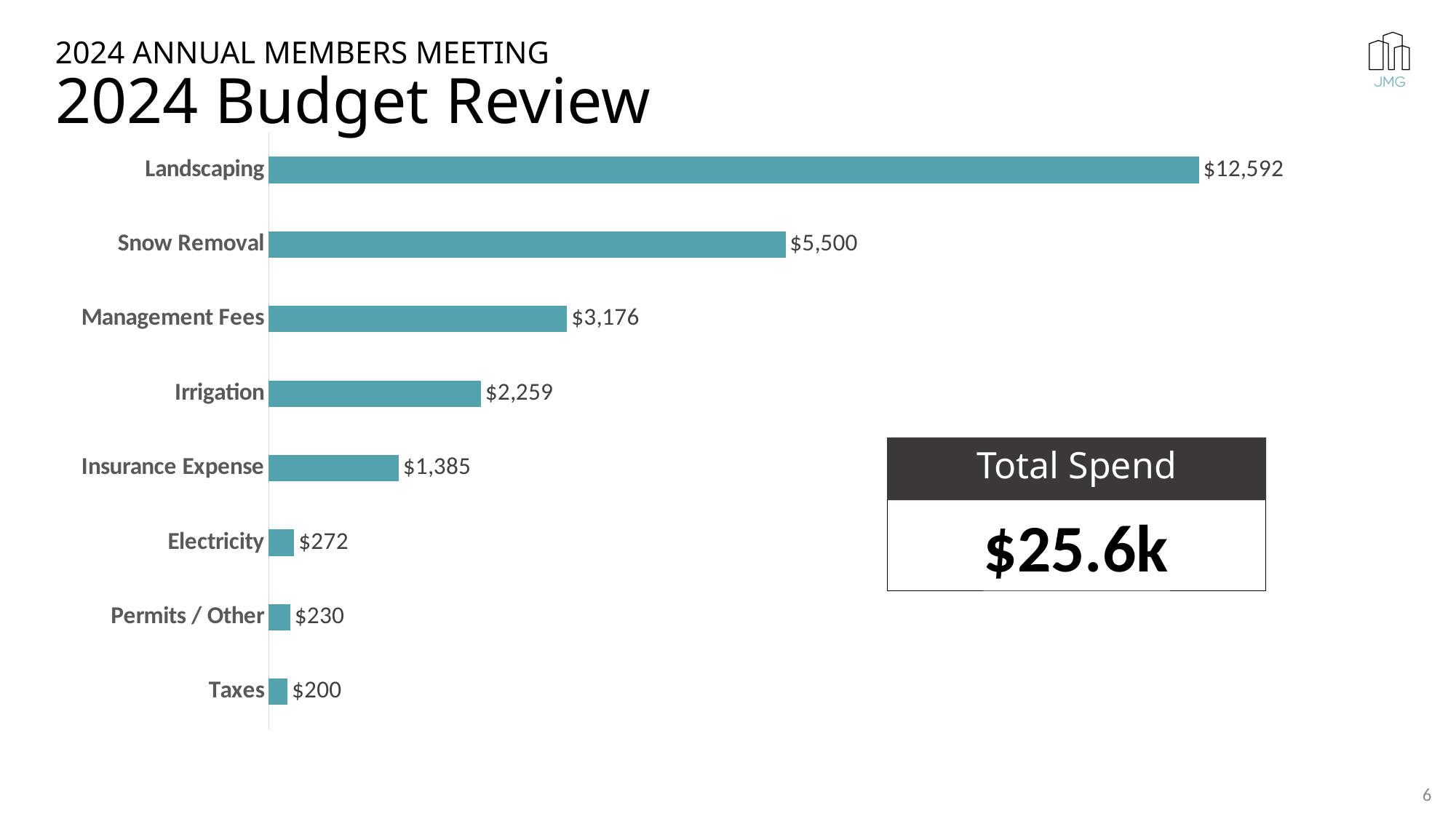
What is the difference between Electricity and Taxes? $72 Which is larger, Irrigation or Insurance Expense? Irrigation What kind of chart is shown on the slide? Bar chart What is the value for Permits / Other? $230 How many categories are shown in the chart? 8 What is the value for Landscaping? $12,592 Which category has the lowest value? Taxes Which category has the highest value? Landscaping What total spend figure is shown in the box next to the chart? $25.6k What is the value for Insurance Expense? $1,385 What is the difference between Snow Removal and Management Fees? $2,324 What is the value for Snow Removal? $5,500